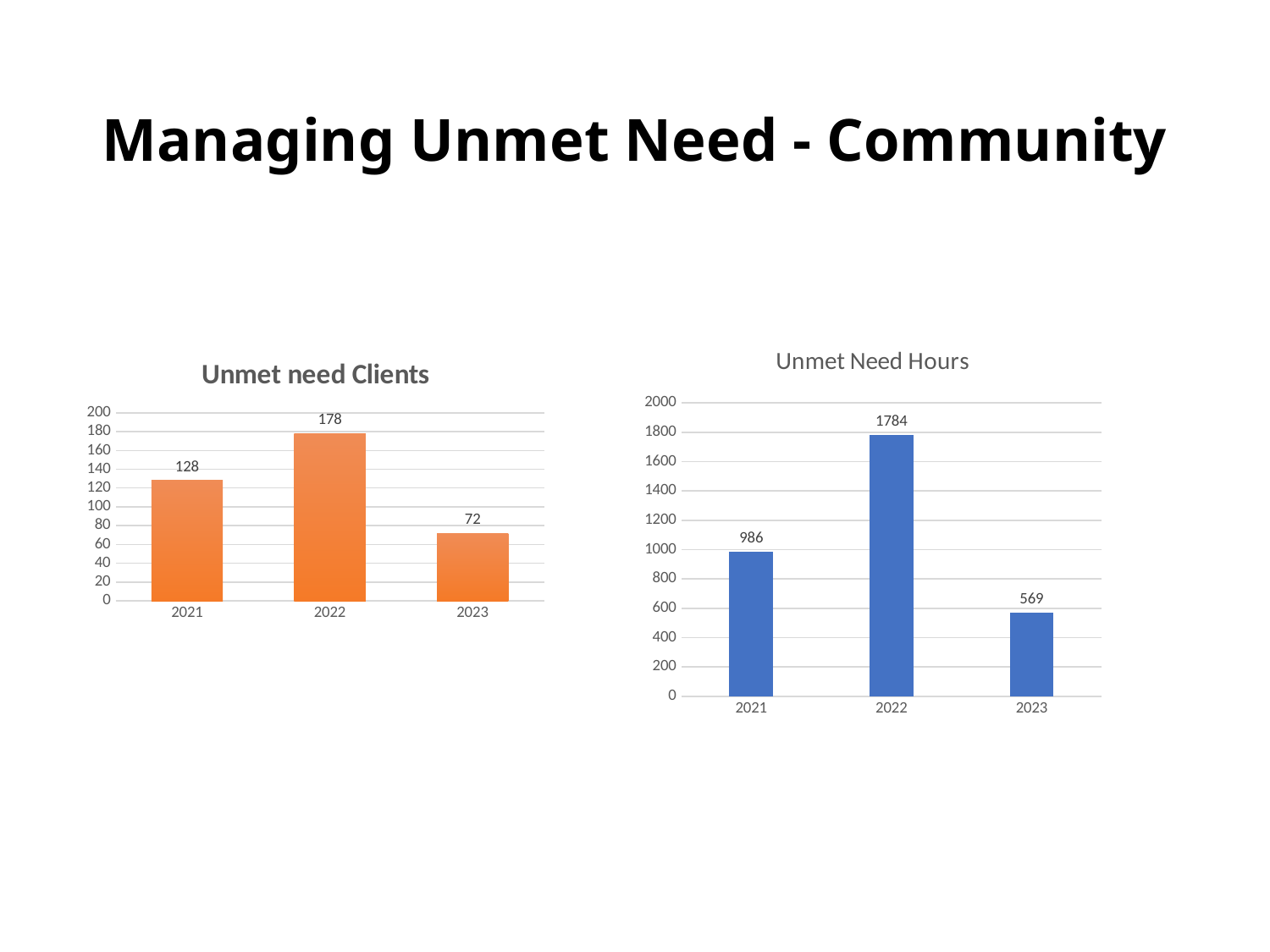
What kind of chart is the 'Unmet need Clients' chart? Bar chart In the 'Unmet Need Hours' chart, what is the difference between the 2022 and 2021 values? 798 In the 'Unmet need Clients' chart, is the value for 2021 greater or less than 100? greater In the 'Unmet Need Hours' chart, what is the value for 2022? 1784 In the 'Unmet Need Hours' chart, what is the value for 2023? 569 In the 'Unmet need Clients' chart, what is the difference between the 2022 and 2023 values? 106 In the 'Unmet Need Hours' chart, which year has the lowest value? 2023 In the 'Unmet need Clients' chart, what is the value for 2023? 72 How many years are shown on the x axis of the 'Unmet Need Hours' chart? 3 In the 'Unmet need Clients' chart, what is the value for 2021? 128 In the 'Unmet Need Hours' chart, which is larger, the value for 2021 or the value for 2023? 2021 In the 'Unmet need Clients' chart, which year has the highest value? 2022